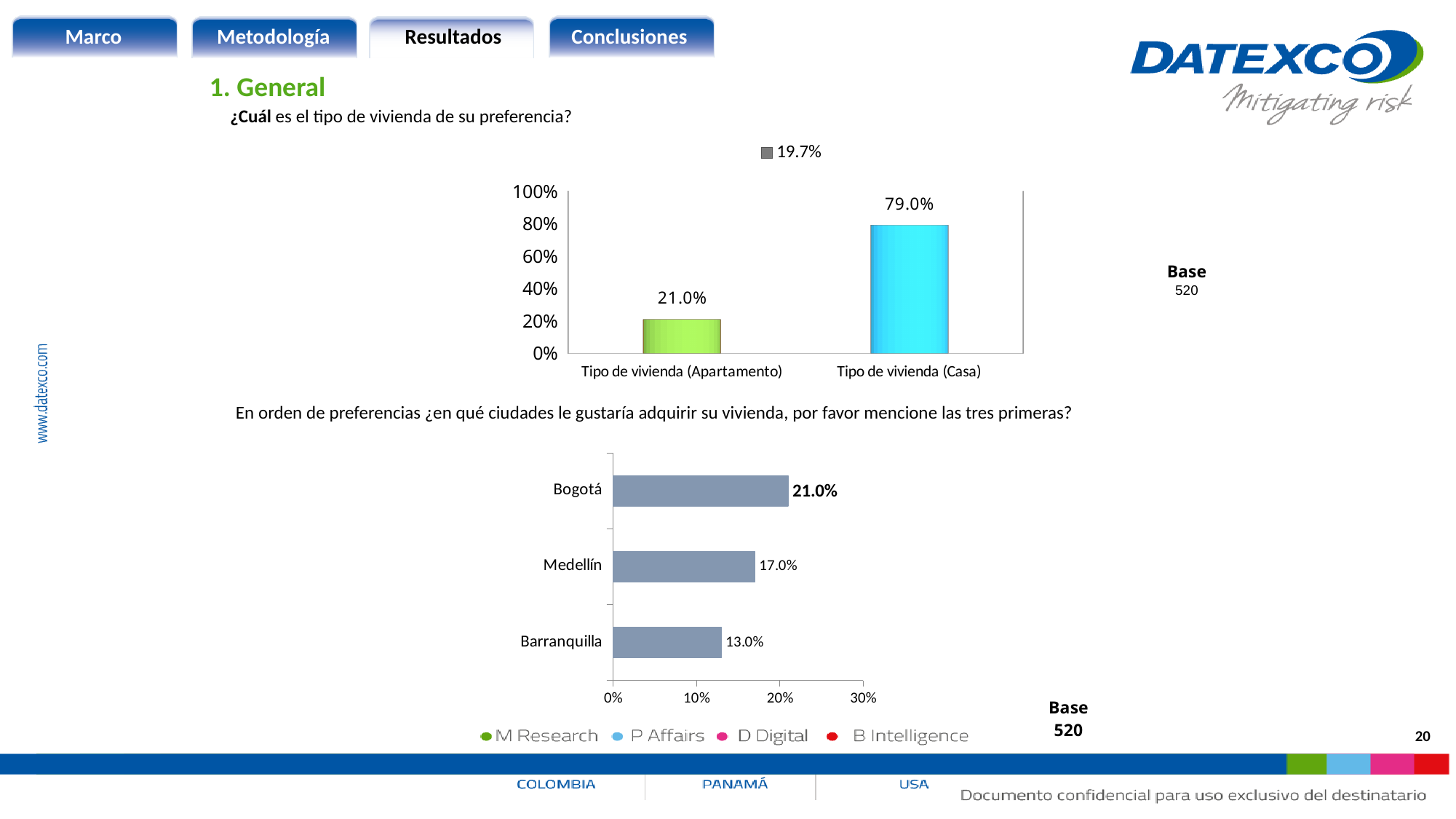
In the top chart (¿Cuál es el tipo de vivienda de su preferencia?), which housing type has the higher value? Tipo de vivienda (Casa) In the top chart (¿Cuál es el tipo de vivienda de su preferencia?), what is the difference between the Casa and Apartamento values? 58.0% In the top chart (¿Cuál es el tipo de vivienda de su preferencia?), how many categories are plotted? 2 In the bottom chart (cities where respondents would like to acquire housing), what is the value for Barranquilla? 13.0% In the top chart (¿Cuál es el tipo de vivienda de su preferencia?), what is the value for Tipo de vivienda (Casa)? 79.0% What kind of chart is the top chart (¿Cuál es el tipo de vivienda de su preferencia?)? Bar chart In the bottom chart (cities where respondents would like to acquire housing), how many cities are plotted? 3 In the bottom chart (cities where respondents would like to acquire housing), which city has the lowest value? Barranquilla In the top chart (¿Cuál es el tipo de vivienda de su preferencia?), what is the value for Tipo de vivienda (Apartamento)? 21.0% In the bottom chart (cities where respondents would like to acquire housing), what is the difference between Bogotá and Barranquilla? 8.0% In the bottom chart (cities where respondents would like to acquire housing), which city has the highest value? Bogotá In the bottom chart (cities where respondents would like to acquire housing), what is the value for Medellín? 17.0%